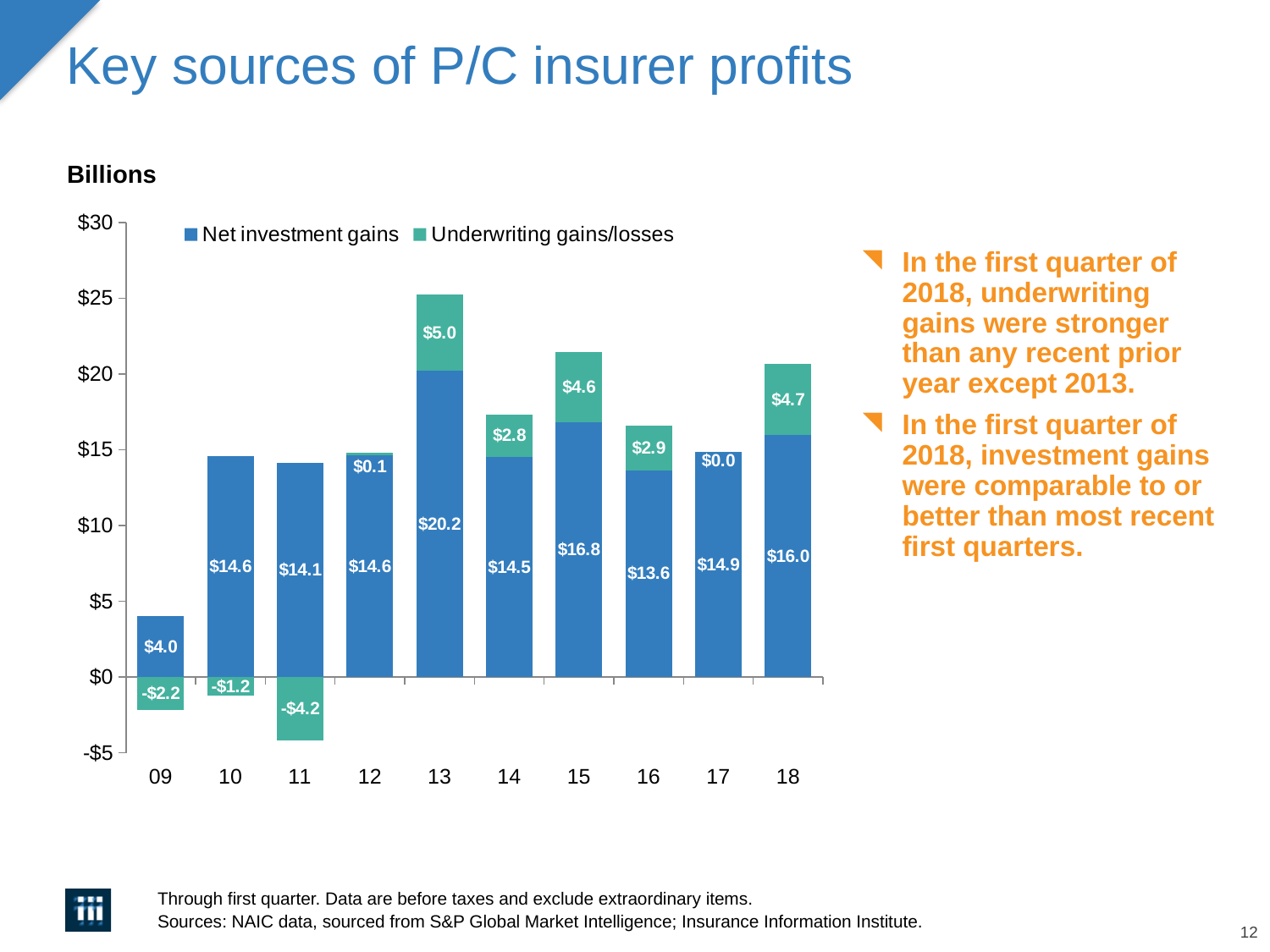
What is the value of Underwriting gains/losses for 18? $4.7 What kind of chart is shown on the slide? Stacked bar chart What is the value of Underwriting gains/losses for 11? -$4.2 What is the difference between Net investment gains in 13 and in 18? $4.2 What is the value of Net investment gains for 13? $20.2 Which is larger, Underwriting gains/losses in 15 or in 16? 15 What is the total of the stacked bar for 15? $21.4 Which year has the lowest Underwriting gains/losses? 11 Which year has the lowest Net investment gains? 09 How many years are shown on the x axis? 10 Which year has the highest Net investment gains? 13 How many series does the legend list? 2